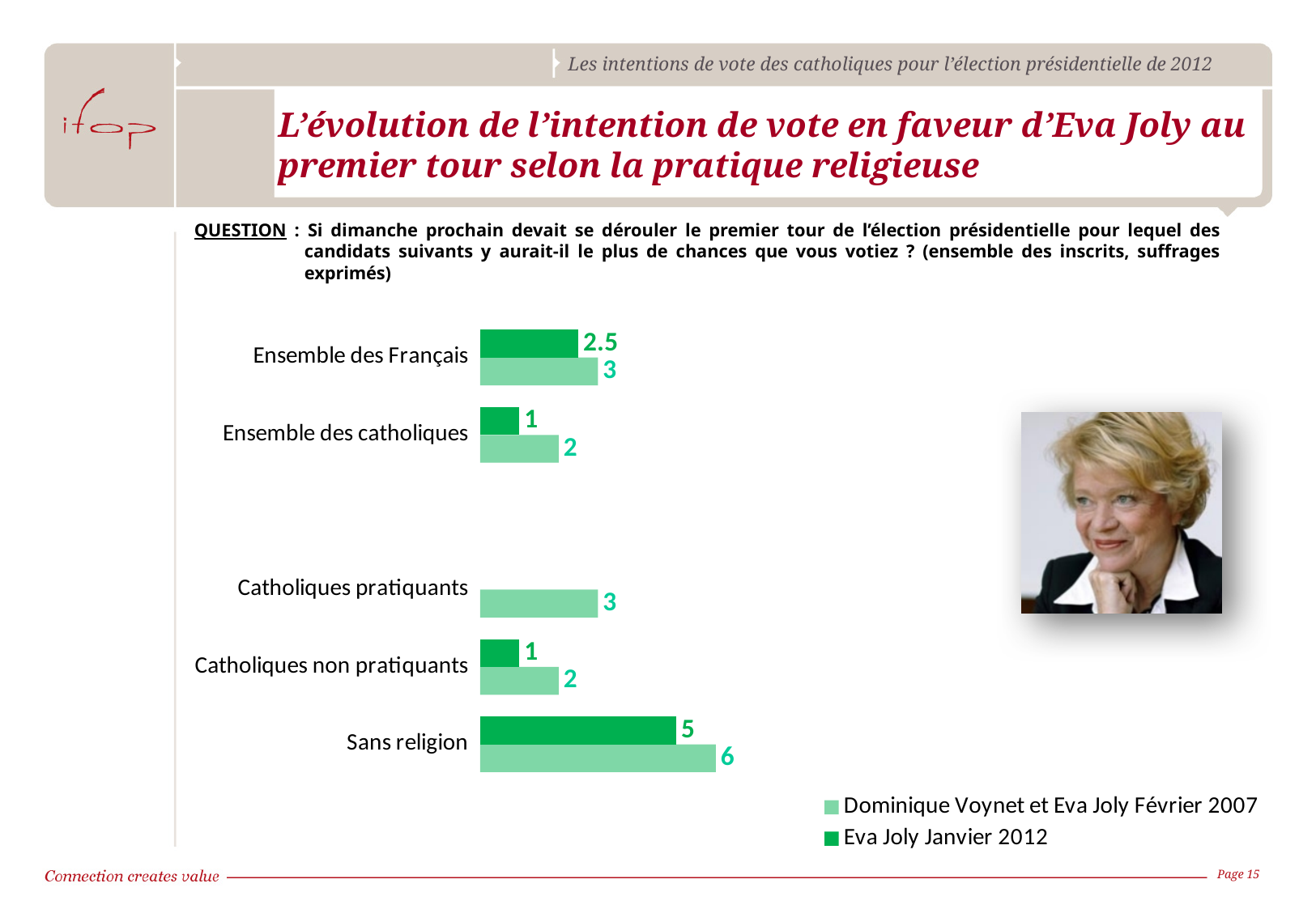
Which category has the highest value in the Dominique Voynet et Eva Joly Février 2007 series? Sans religion What is the value for Sans religion in the Eva Joly Janvier 2012 series? 5 What is the difference between the Février 2007 and Janvier 2012 values for Sans religion? 1 What is the value for Catholiques pratiquants in the Dominique Voynet et Eva Joly Février 2007 series? 3 Which category has the highest value in the Eva Joly Janvier 2012 series? Sans religion What kind of chart is shown on the slide? Bar chart What is the difference between the Février 2007 and Janvier 2012 values for Ensemble des Français? 0.5 How many categories are shown on the chart? 5 For Catholiques non pratiquants, which is larger: the Février 2007 value or the Janvier 2012 value? Février 2007 What is the value for Ensemble des Français in the Dominique Voynet et Eva Joly Février 2007 series? 3 How many series does the legend list? 2 What is the value for Ensemble des catholiques in the Eva Joly Janvier 2012 series? 1